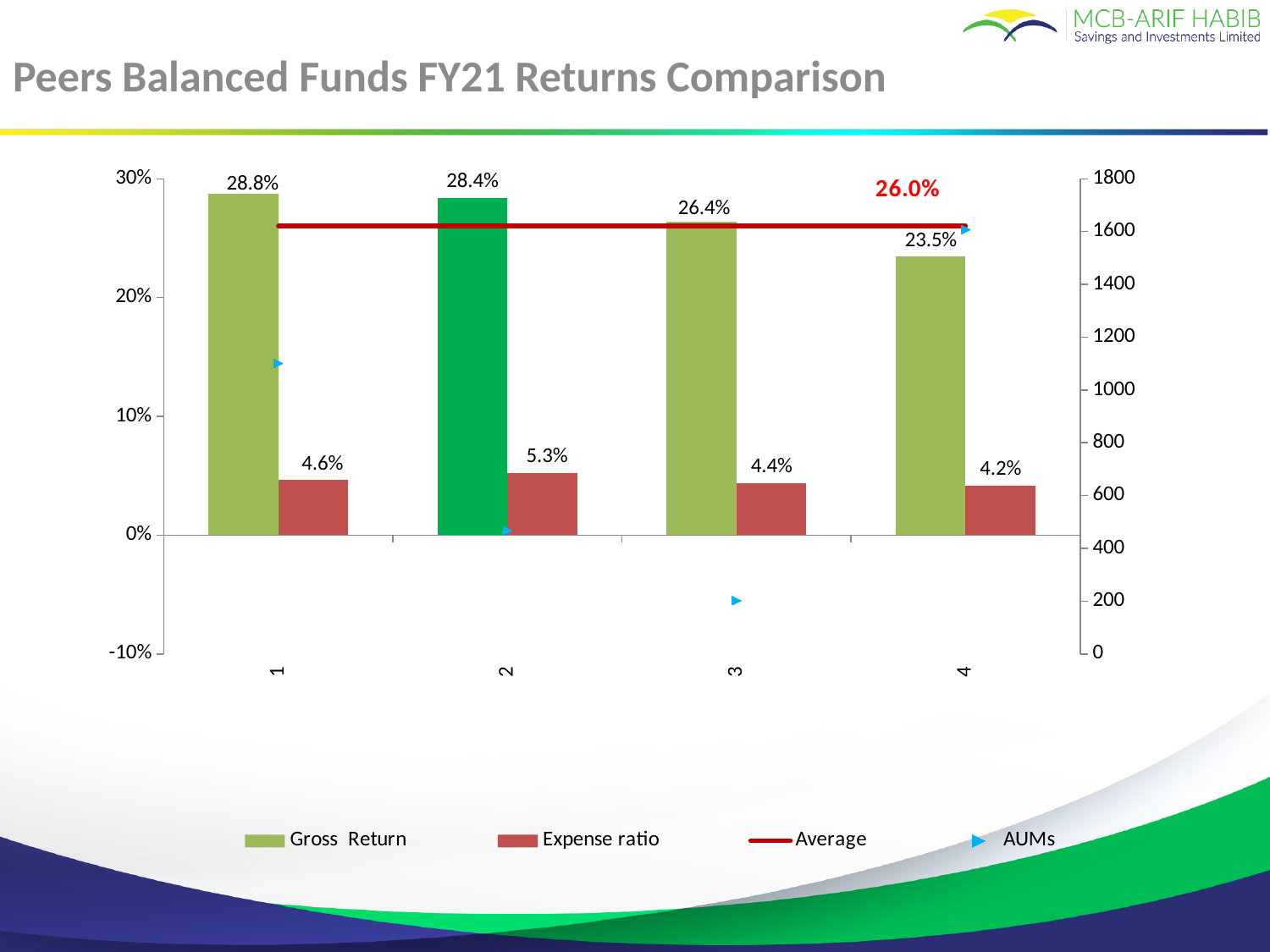
What is the difference between the Gross Return of fund 1 and fund 4? 5.3% Which fund has the lowest Expense ratio? 4 Which fund has the highest Gross Return? 1 What is the Expense ratio for fund 2? 5.3% What is the Gross Return for fund 1? 28.8% Do the Gross Return values rise or fall from fund 1 to fund 4? fall How many funds are shown on the x axis? 4 Is the AUMs value for fund 3 greater or less than 400 on the right axis? less Which is larger, the Expense ratio of fund 1 or fund 3? fund 1 How many series does the legend list? 4 What value is shown for the Average line? 26.0% What kind of chart is used for the Gross Return and Expense ratio series? bar chart